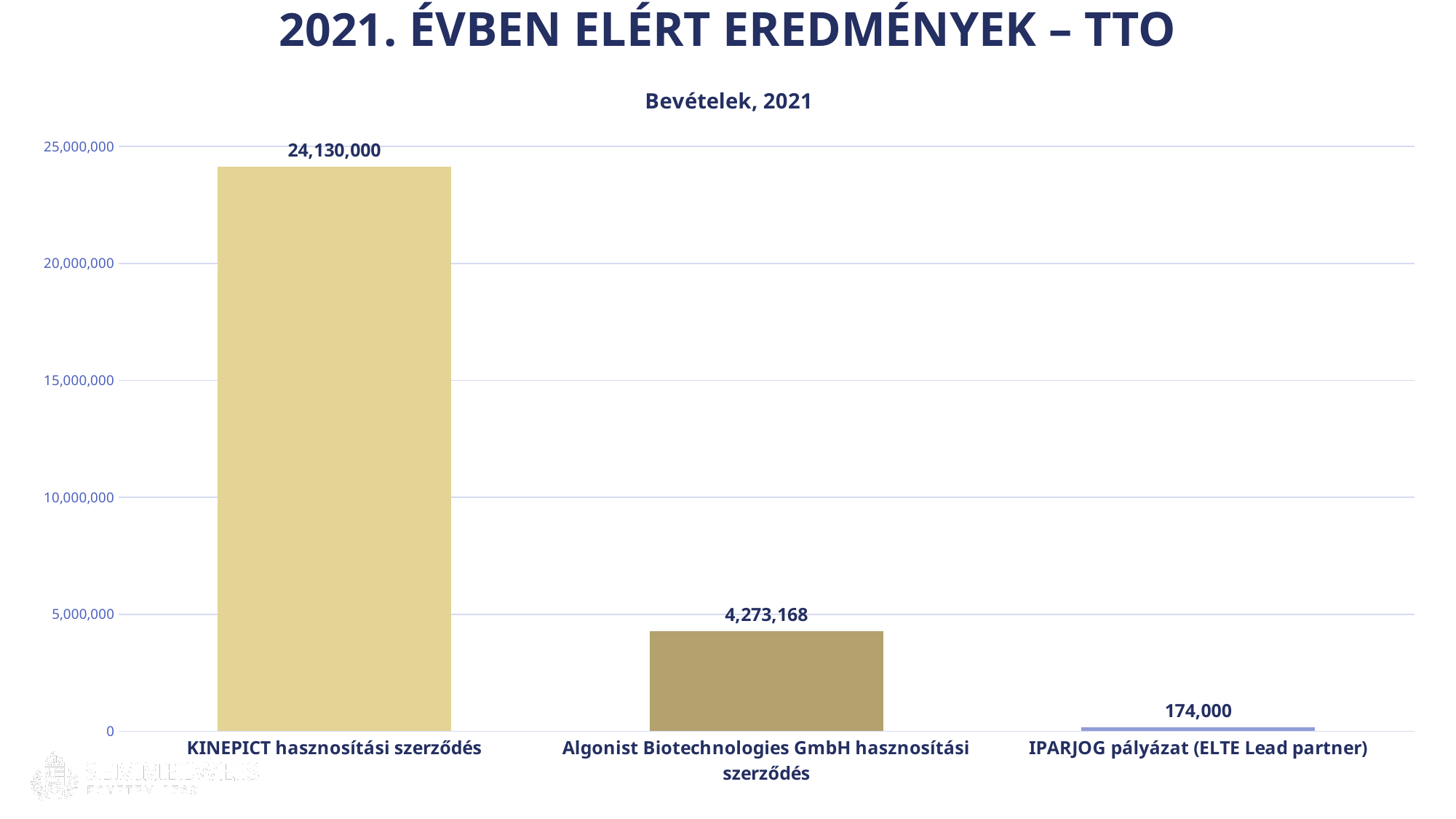
How many categories are shown in the chart? 3 Which category has the lowest value? IPARJOG pályázat (ELTE Lead partner) Which category has the highest value? KINEPICT hasznosítási szerződés What kind of chart is shown on the slide? bar chart What is the difference between the values for Algonist Biotechnologies GmbH hasznosítási szerződés and IPARJOG pályázat (ELTE Lead partner)? 4,099,168 What is the difference between the values for KINEPICT hasznosítási szerződés and Algonist Biotechnologies GmbH hasznosítási szerződés? 19,856,832 What is the value for Algonist Biotechnologies GmbH hasznosítási szerződés? 4,273,168 What is the value for IPARJOG pályázat (ELTE Lead partner)? 174,000 What is the value for KINEPICT hasznosítási szerződés? 24,130,000 Which is larger, the value for Algonist Biotechnologies GmbH hasznosítási szerződés or the value for IPARJOG pályázat (ELTE Lead partner)? Algonist Biotechnologies GmbH hasznosítási szerződés What is the title of the chart? Bevételek, 2021 Is the value for Algonist Biotechnologies GmbH hasznosítási szerződés greater or less than 5,000,000? less